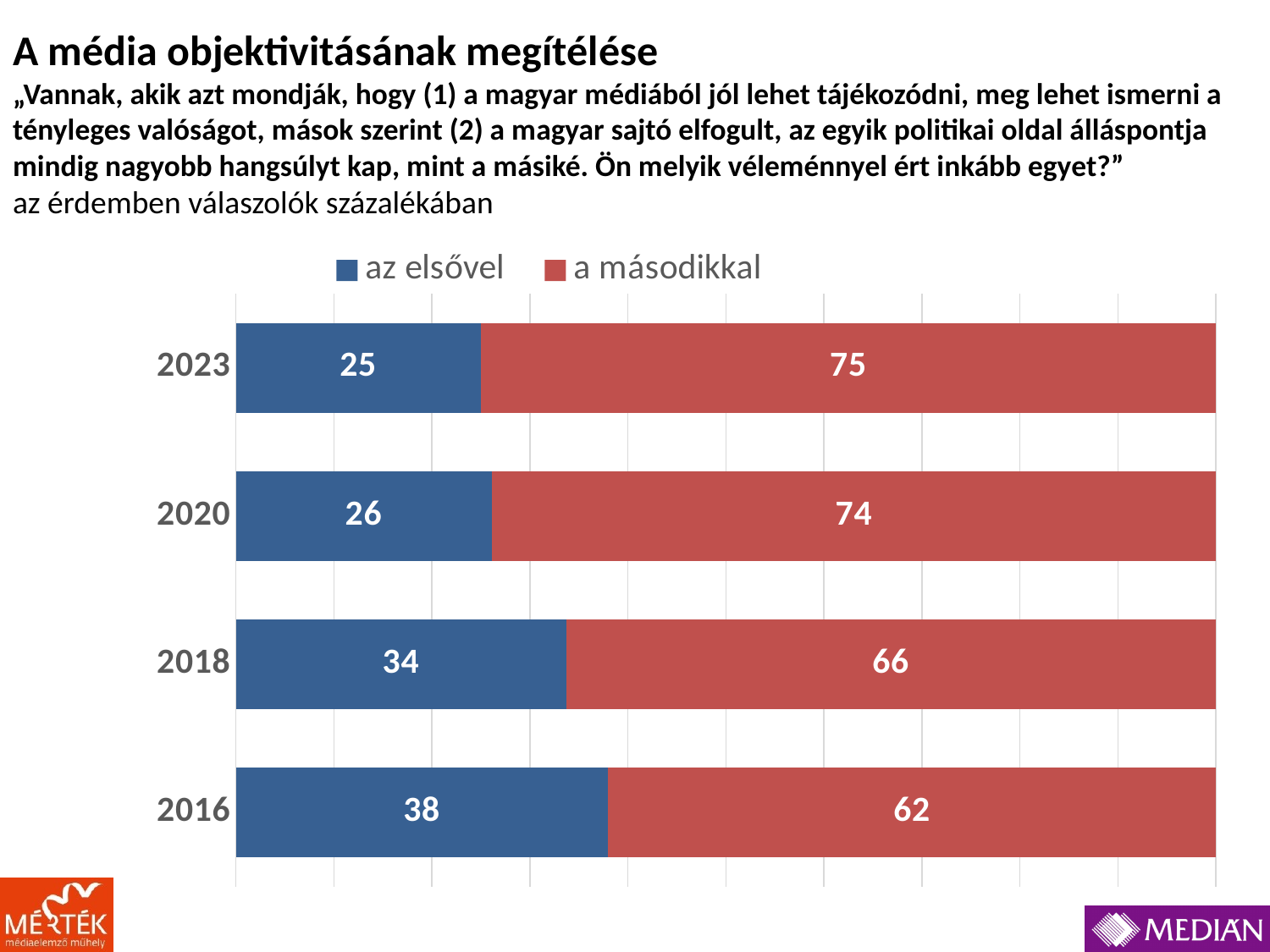
How many series does the legend list? 2 What is the total of the stacked bar for 2018? 100 Which is larger: the "az elsővel" value in 2018 or in 2020? 2018 How many years are shown on the chart? 4 In which year is the value for "a másodikkal" lowest? 2016 What is the value for "a másodikkal" in 2018? 66 In which year is the value for "az elsővel" highest? 2016 Which colour represents "a másodikkal" in the chart? red What kind of chart is shown on the slide? stacked bar chart What is the value for "az elsővel" in 2023? 25 What is the difference between the "a másodikkal" value in 2023 and in 2016? 13 What is the value for "a másodikkal" in 2020? 74